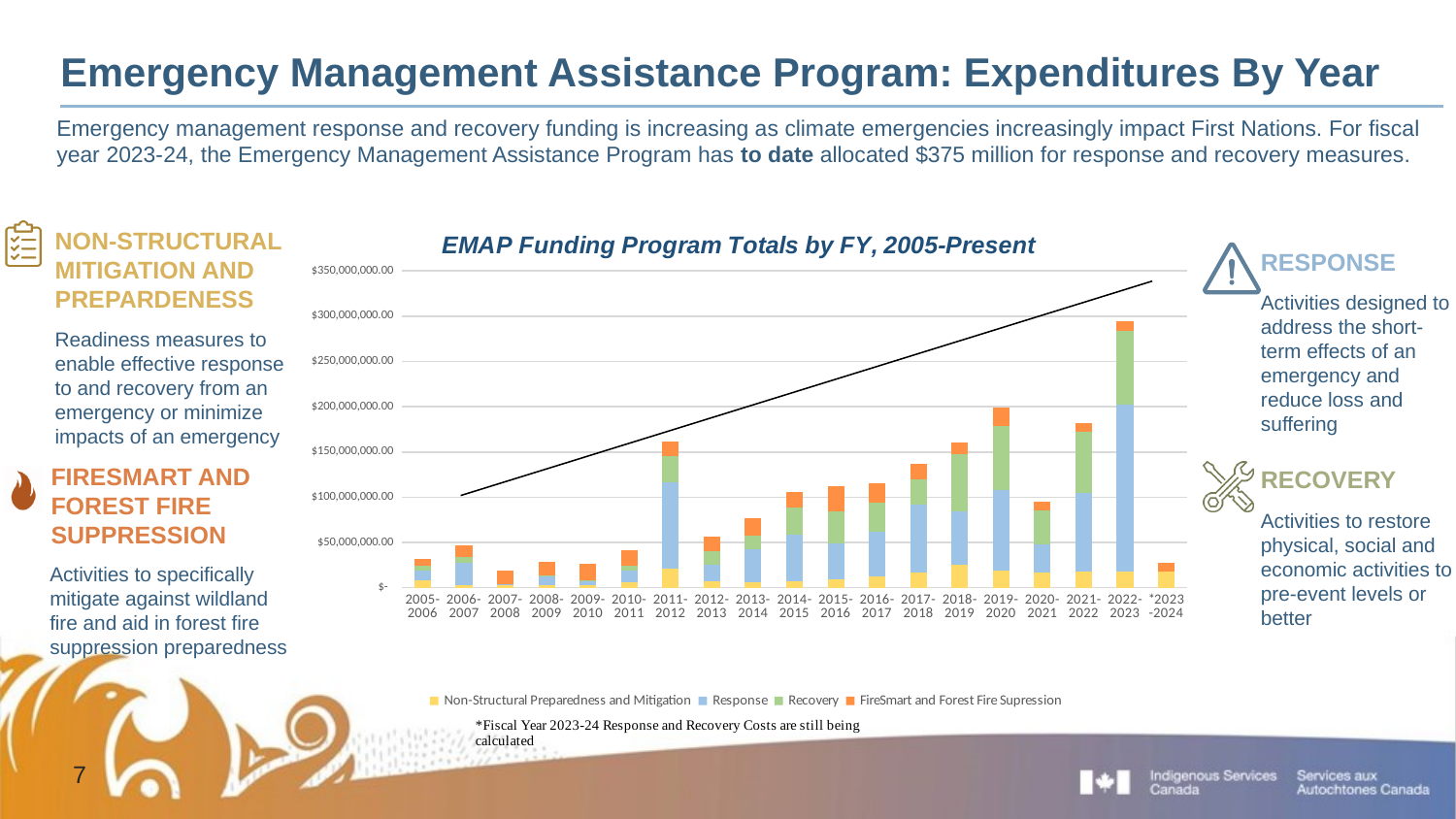
Is the total for 2019-2020 greater or less than $150,000,000.00? greater Do the total expenditures generally rise or fall from 2005-2006 to 2022-2023? rise What kind of chart is shown on the slide? Stacked bar chart Which has the larger total bar, 2011-2012 or 2012-2013? 2011-2012 How many fiscal-year categories are plotted along the x axis? 19 Is the total for 2011-2012 greater or less than $100,000,000.00? greater What is the title of the chart? EMAP Funding Program Totals by FY, 2005-Present Is the total for 2007-2008 greater or less than $50,000,000.00? less How many series does the chart legend list? 4 Which series is shown in blue in the legend? Response Which fiscal year has the highest total bar? 2022-2023